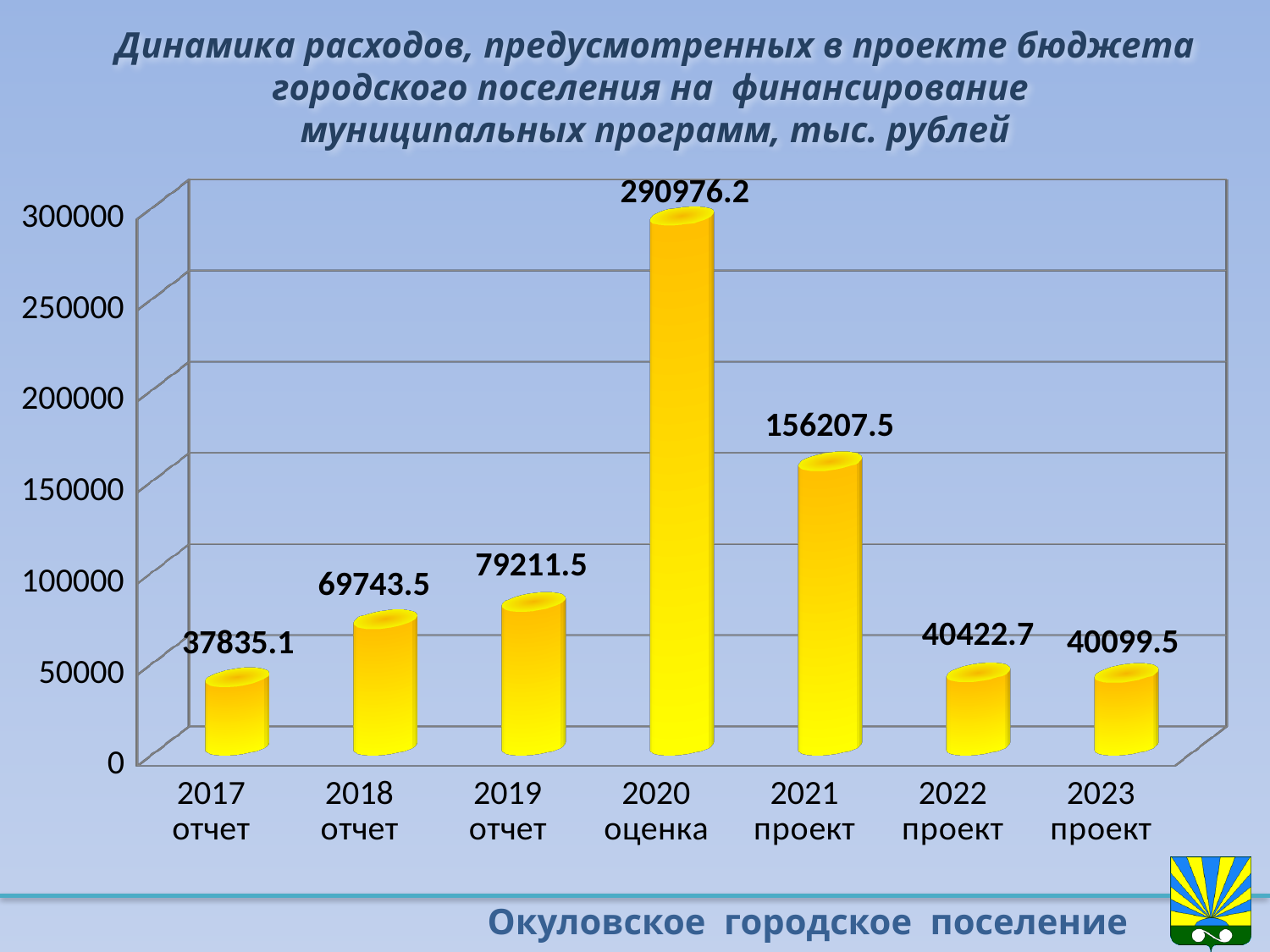
Which category has the highest value? 2020 оценка What is the value for 2017 отчет? 37835.1 What kind of chart is shown on the slide? bar chart Which is larger, the value for 2021 проект or the value for 2019 отчет? 2021 проект Do the values rise or fall from 2017 отчет to 2019 отчет? rise Which category has the lowest value? 2017 отчет Is the value for 2021 проект greater or less than 150000? greater What is the difference between the values for 2019 отчет and 2018 отчет? 9468 What is the difference between the values for 2020 оценка and 2021 проект? 134768.7 What is the value for 2023 проект? 40099.5 How many categories are shown on the x axis? 7 What is the value for 2020 оценка? 290976.2